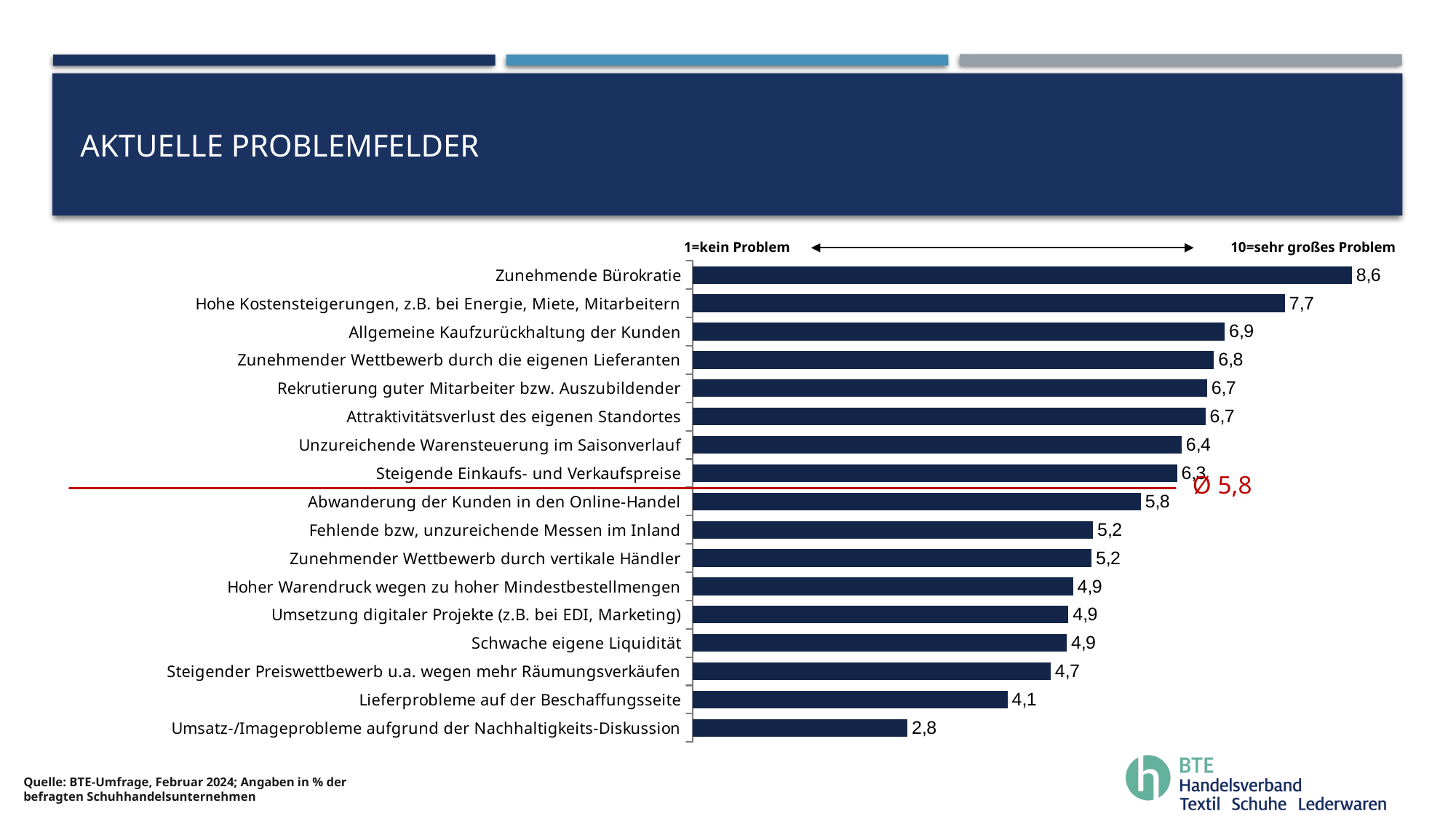
What is the value for "Zunehmende Bürokratie"? 8,6 What is the value for "Unzureichende Warensteuerung im Saisonverlauf"? 6,4 What average value (Ø) is marked in red on the chart? 5,8 What is the difference between the values for "Allgemeine Kaufzurückhaltung der Kunden" and "Umsatz-/Imageprobleme aufgrund der Nachhaltigkeits-Diskussion"? 4,1 What is the value for "Lieferprobleme auf der Beschaffungsseite"? 4,1 Which has a larger value, "Steigender Preiswettbewerb u.a. wegen mehr Räumungsverkäufen" or "Fehlende bzw, unzureichende Messen im Inland"? Fehlende bzw, unzureichende Messen im Inland What is the value for "Abwanderung der Kunden in den Online-Handel"? 5,8 How many categories are shown in the chart? 17 What kind of chart is shown on the slide? Bar chart Which category has the lowest value? Umsatz-/Imageprobleme aufgrund der Nachhaltigkeits-Diskussion What is the difference between the values for "Zunehmende Bürokratie" and "Hohe Kostensteigerungen, z.B. bei Energie, Miete, Mitarbeitern"? 0,9 Which category has the highest value? Zunehmende Bürokratie